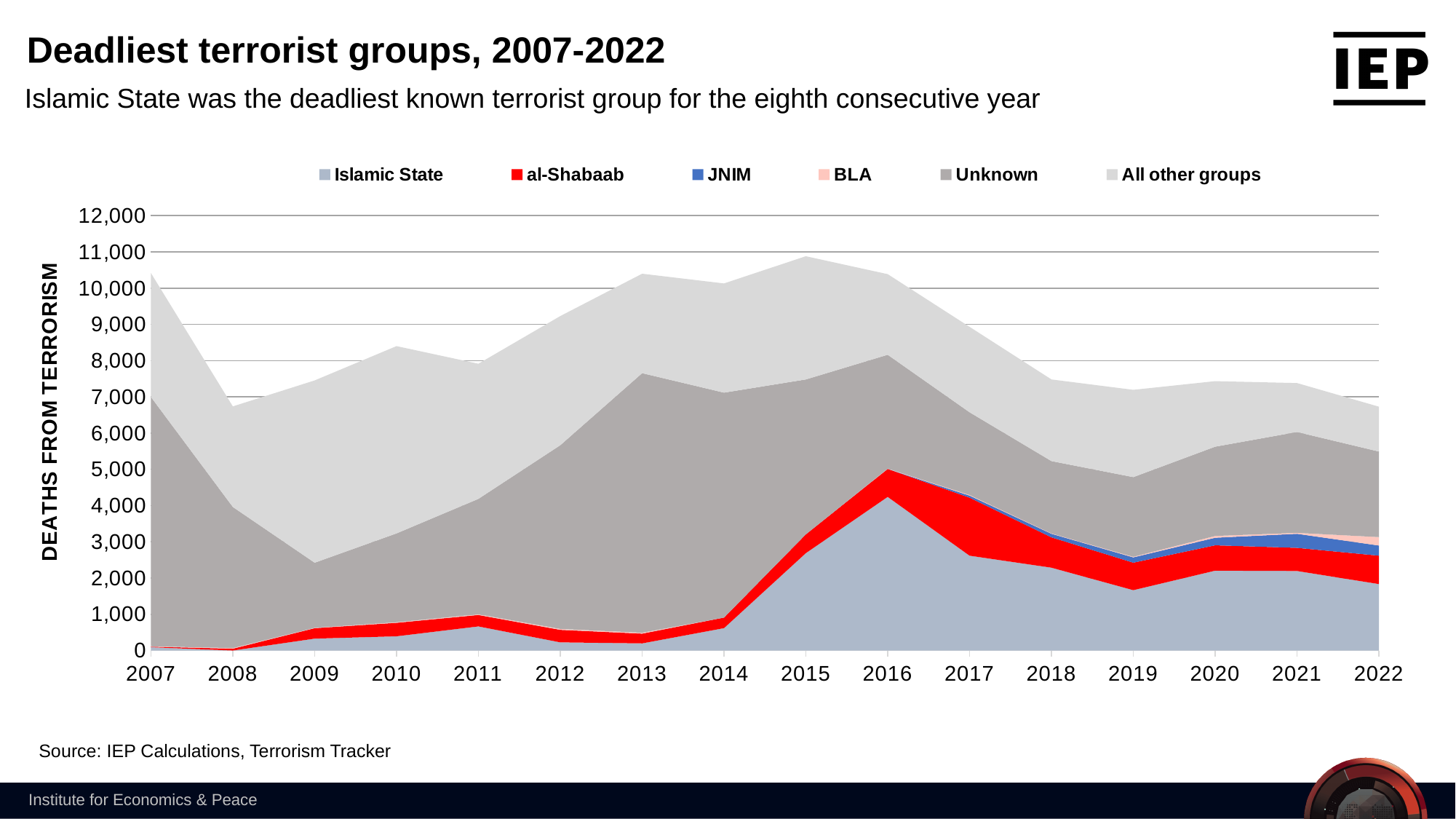
How many series does the legend list? 6 Is the total number of deaths from terrorism in 2015 greater or less than 10,000? greater Which colour represents al-Shabaab in the chart? Red Does the total number of deaths from terrorism rise or fall between 2015 and 2019? fall In which year does the total number of deaths from terrorism (top of the stacked area) reach its highest point? 2015 In which year does the Islamic State series reach its highest value? 2016 Is the value for Islamic State in 2016 greater or less than 4,000? greater What kind of chart is shown on the slide? Stacked area chart Which year has a larger value for Islamic State, 2013 or 2016? 2016 Is the value for Islamic State in 2019 greater or less than 2,000? less How many years are shown along the x axis? 16